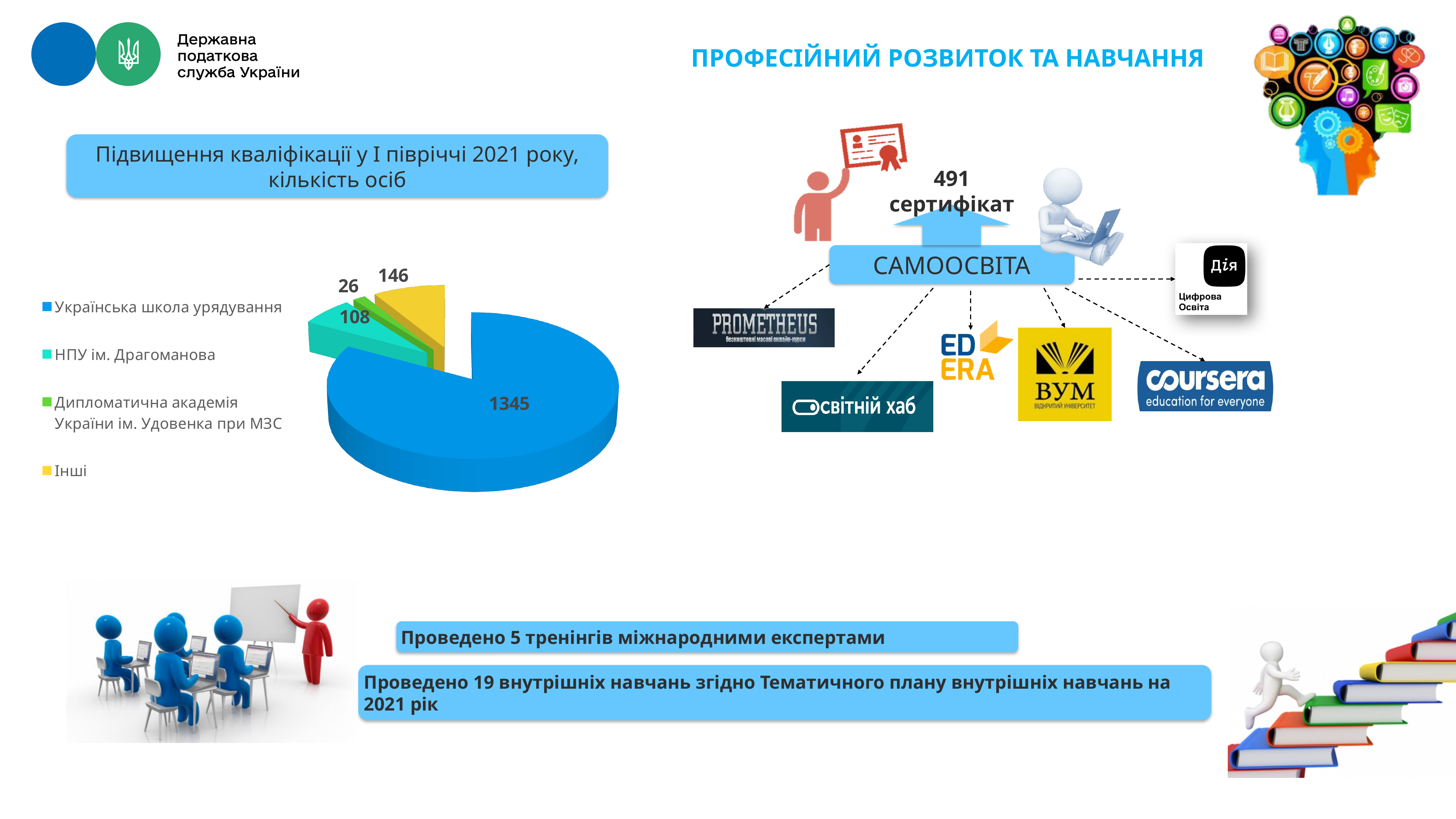
What is the title of the pie chart? Підвищення кваліфікації у І півріччі 2021 року, кількість осіб Which category has the smallest slice in the pie chart? Дипломатична академія України ім. Удовенка при МЗС What kind of chart is shown on the slide? Pie chart How many categories does the pie chart show? 4 What is the value for Українська школа урядування in the pie chart? 1345 What is the value for Дипломатична академія України ім. Удовенка при МЗС in the pie chart? 26 What is the value for Інші in the pie chart? 146 What is the difference between the values for Інші and НПУ ім. Драгоманова? 38 Which is larger: the value for Інші or the value for НПУ ім. Драгоманова? Інші Which category has the largest slice in the pie chart? Українська школа урядування What is the difference between the values for Українська школа урядування and Інші? 1199 What is the value for НПУ ім. Драгоманова in the pie chart? 108